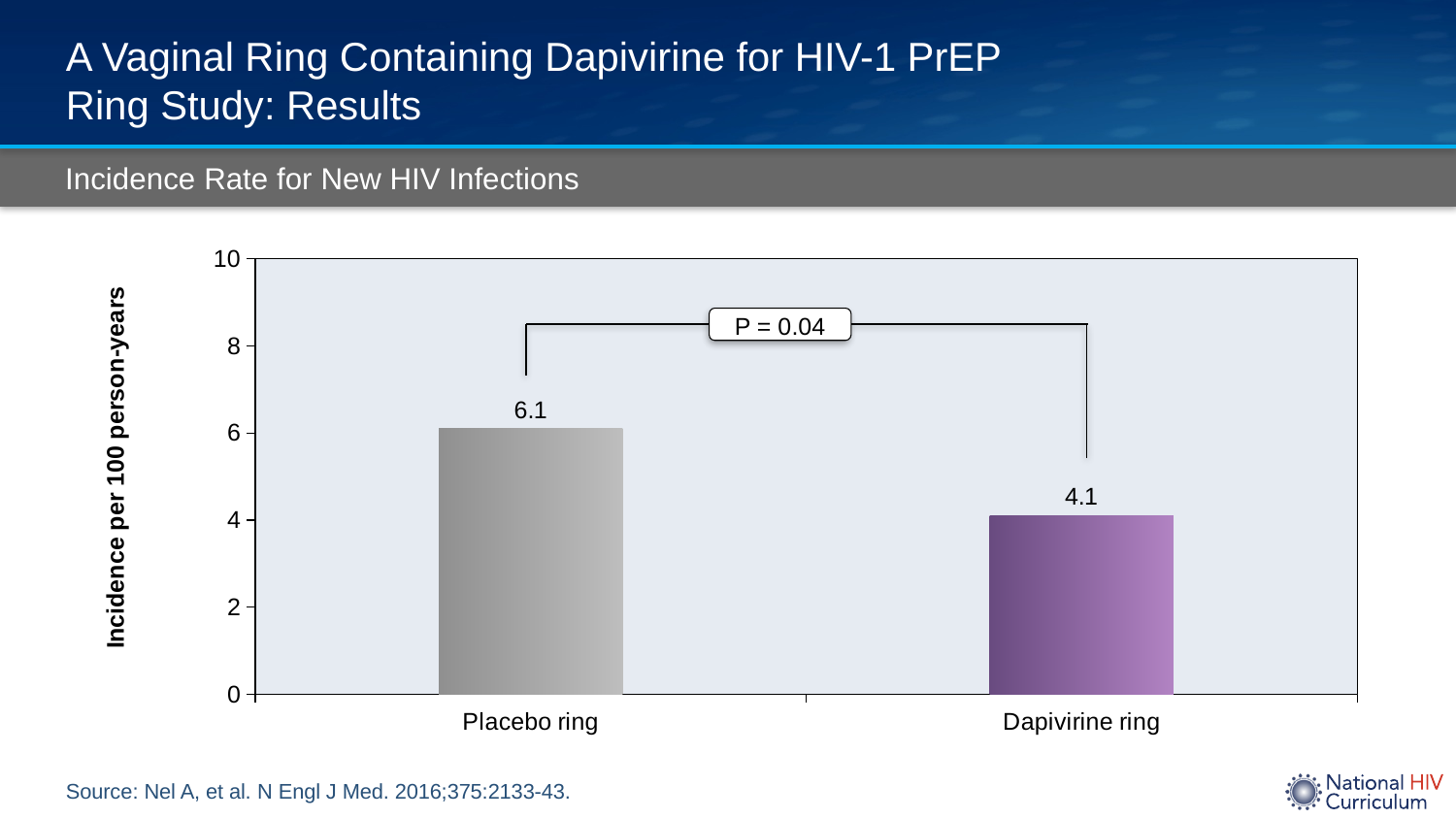
What is the incidence rate for the Dapivirine ring? 4.1 What is the incidence rate for the Placebo ring? 6.1 Which group has the higher incidence rate? Placebo ring Is the incidence rate for the Placebo ring larger or smaller than that for the Dapivirine ring? larger How many categories are shown on the x axis? 2 Is the incidence rate for the Dapivirine ring greater or less than 6? less Is the incidence rate for the Placebo ring greater or less than 4? greater What kind of chart is shown on the slide? Bar chart What is the difference in incidence rate between the Placebo ring and the Dapivirine ring? 2.0 What is the label of the y axis? Incidence per 100 person-years What P value is shown on the chart? P = 0.04 Which group has the lower incidence rate? Dapivirine ring